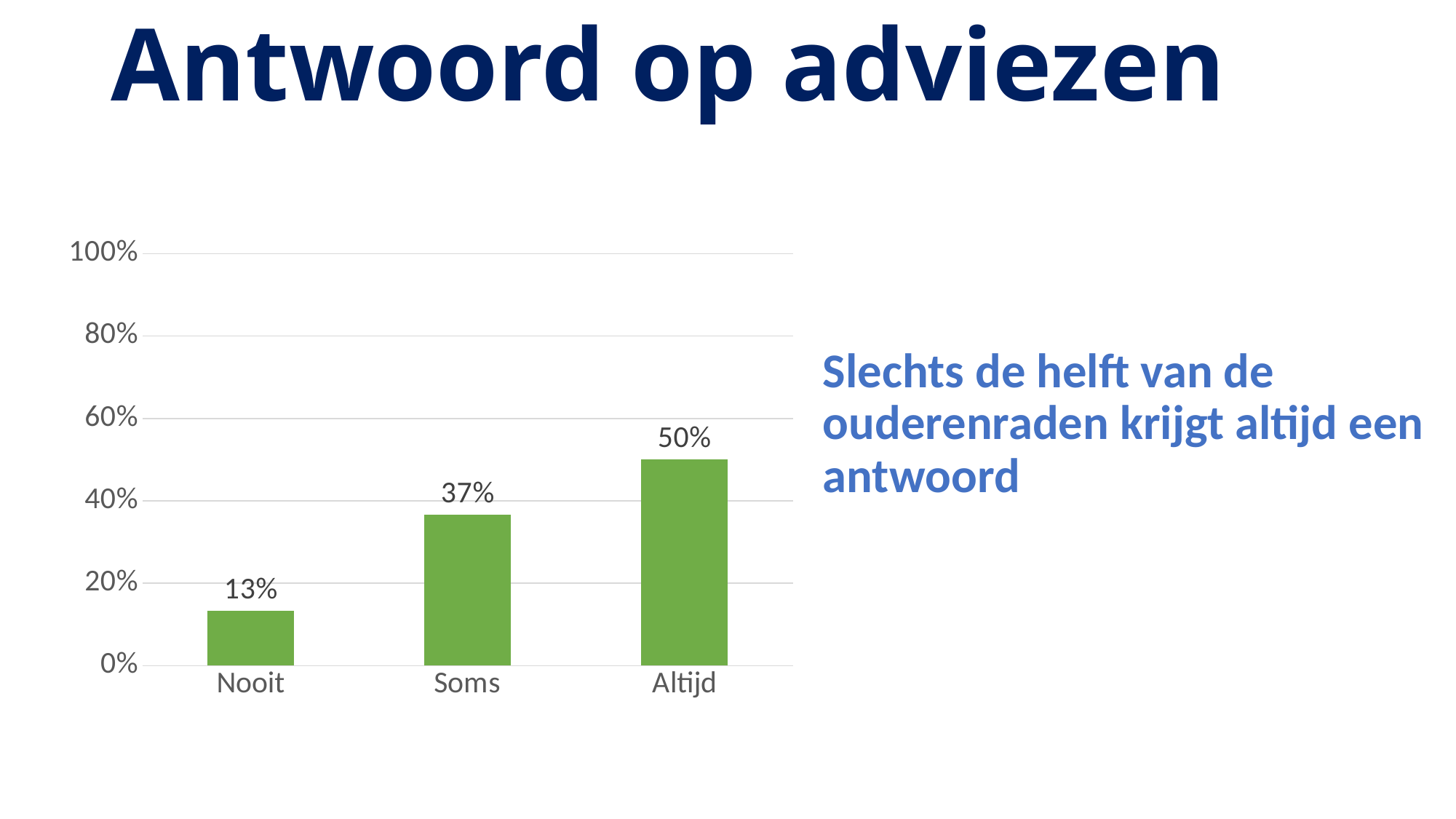
Which category has the highest value? Altijd Which category has the lowest value? Nooit How many categories are shown on the x axis? 3 What is the value for Altijd? 50% What is the difference between the values for Soms and Nooit? 24% Which is larger, the value for Soms or the value for Nooit? Soms What kind of chart is shown on the slide? bar chart What is the difference between the values for Altijd and Soms? 13% Do the values rise or fall from Nooit to Altijd along the x axis? rise What is the value for Soms? 37% Is the value for Soms greater or less than 40%? less What is the value for Nooit? 13%